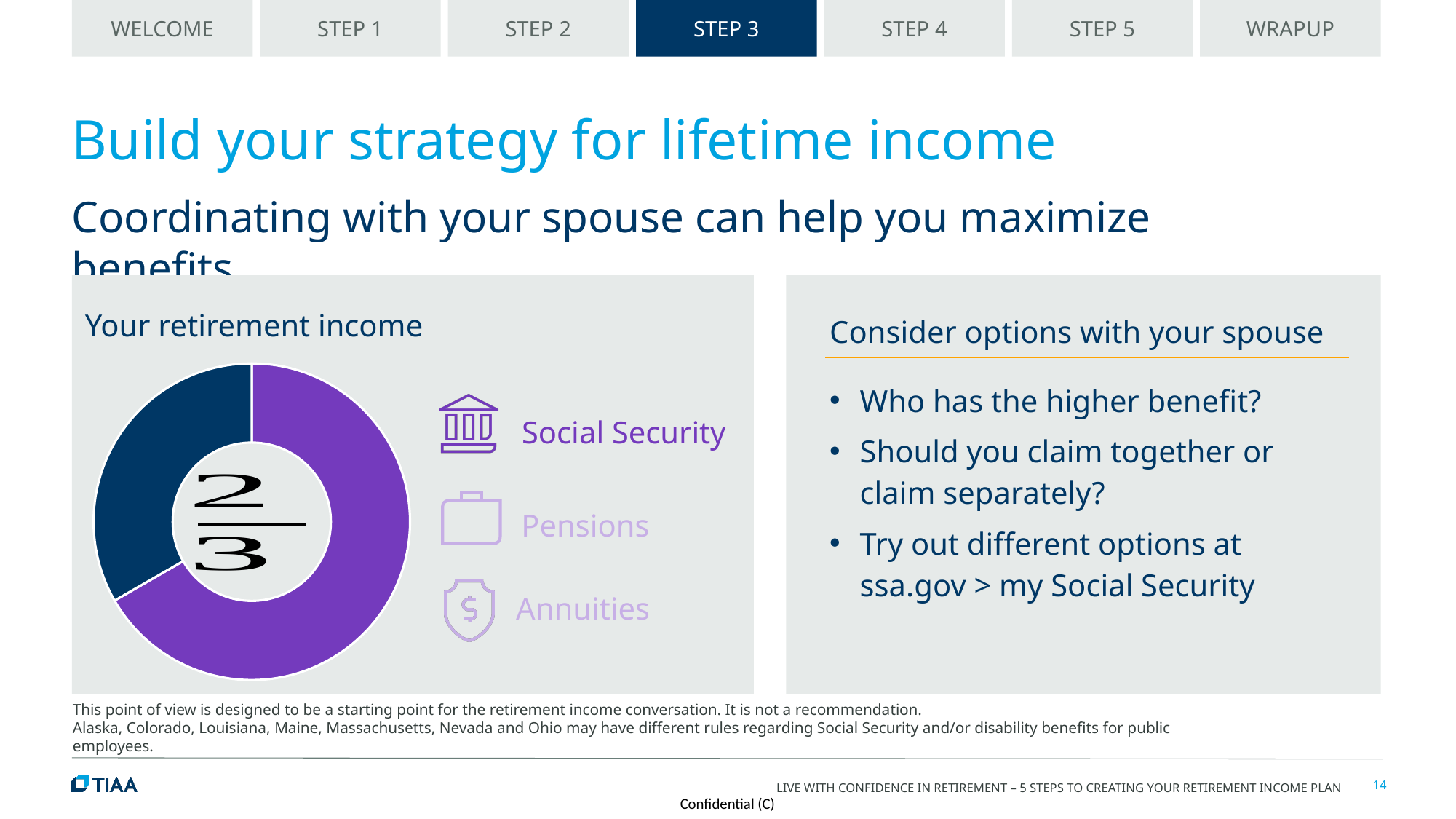
What kind of chart is shown under "Your retirement income"? Pie chart (donut) What fraction of retirement income does the "Your retirement income" chart attribute to Social Security? 2/3 What colour is the Social Security slice in the "Your retirement income" chart? Purple Which slice is larger in the "Your retirement income" chart, the purple Social Security slice or the dark navy slice? Social Security (purple) How many slices does the "Your retirement income" chart have? 2 Which category takes the largest share of the "Your retirement income" chart? Social Security Is the Social Security share in the "Your retirement income" chart greater or less than one half? greater What is the title of the chart on the left of the slide? Your retirement income